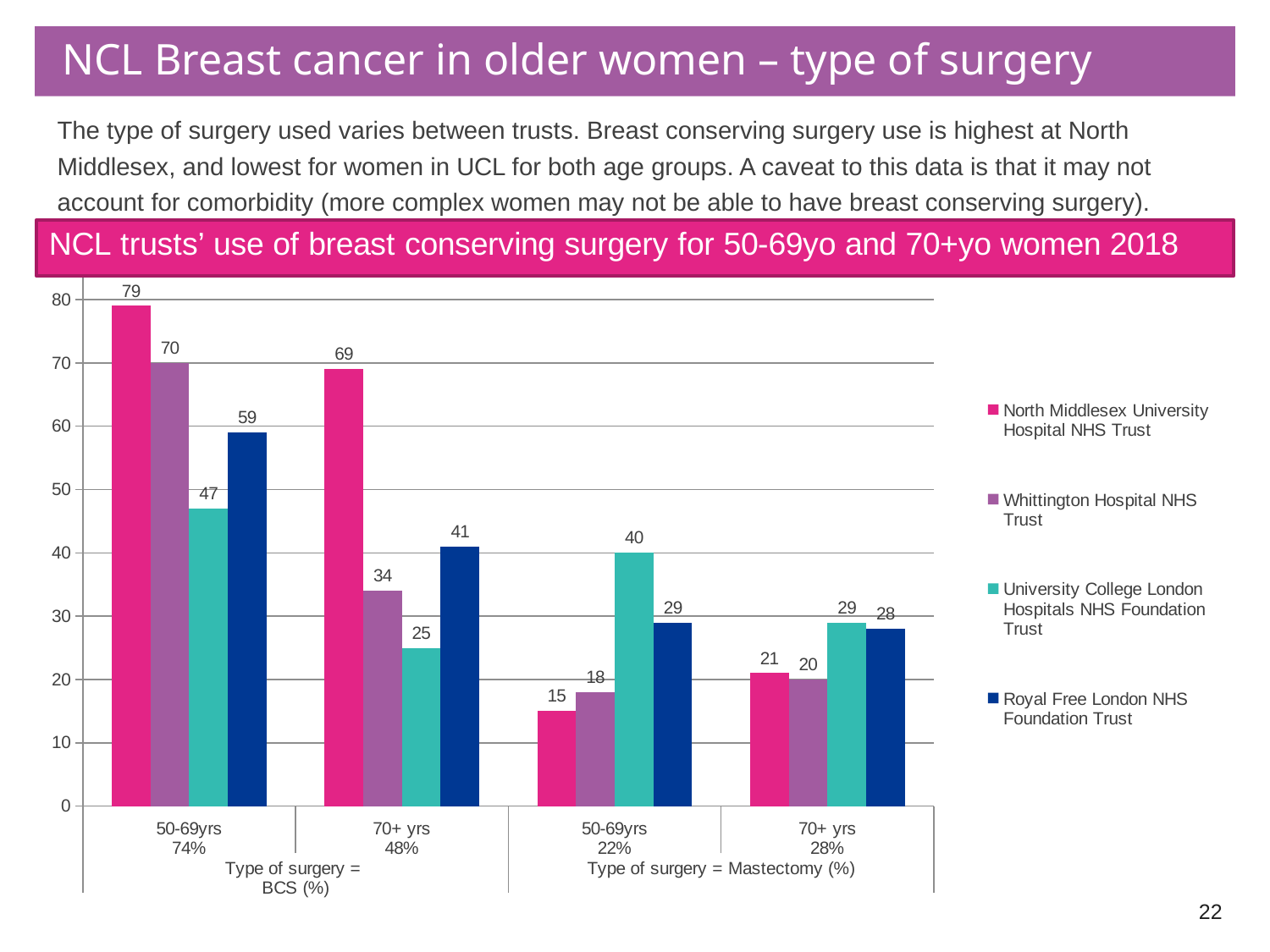
What kind of chart is shown on the slide? Bar chart What is the value for North Middlesex University Hospital NHS Trust in the 50-69yrs BCS category? 79 Which trust has the lowest value in the 70+ yrs BCS category? University College London Hospitals NHS Foundation Trust What is the difference between the North Middlesex and Whittington values in the 70+ yrs BCS category? 35 Which trust has the highest value in the 50-69yrs Mastectomy category? University College London Hospitals NHS Foundation Trust How many category groups are shown along the x axis? 4 What is the value for Whittington Hospital NHS Trust in the 70+ yrs Mastectomy category? 20 Which is larger: the Royal Free value for 50-69yrs BCS or the Whittington value for 50-69yrs BCS? Whittington Hospital NHS Trust What is the value for Royal Free London NHS Foundation Trust in the 50-69yrs Mastectomy category? 29 What is the value for University College London Hospitals NHS Foundation Trust in the 70+ yrs BCS category? 25 How many series does the legend list? 4 What colour represents North Middlesex University Hospital NHS Trust in the chart? Pink